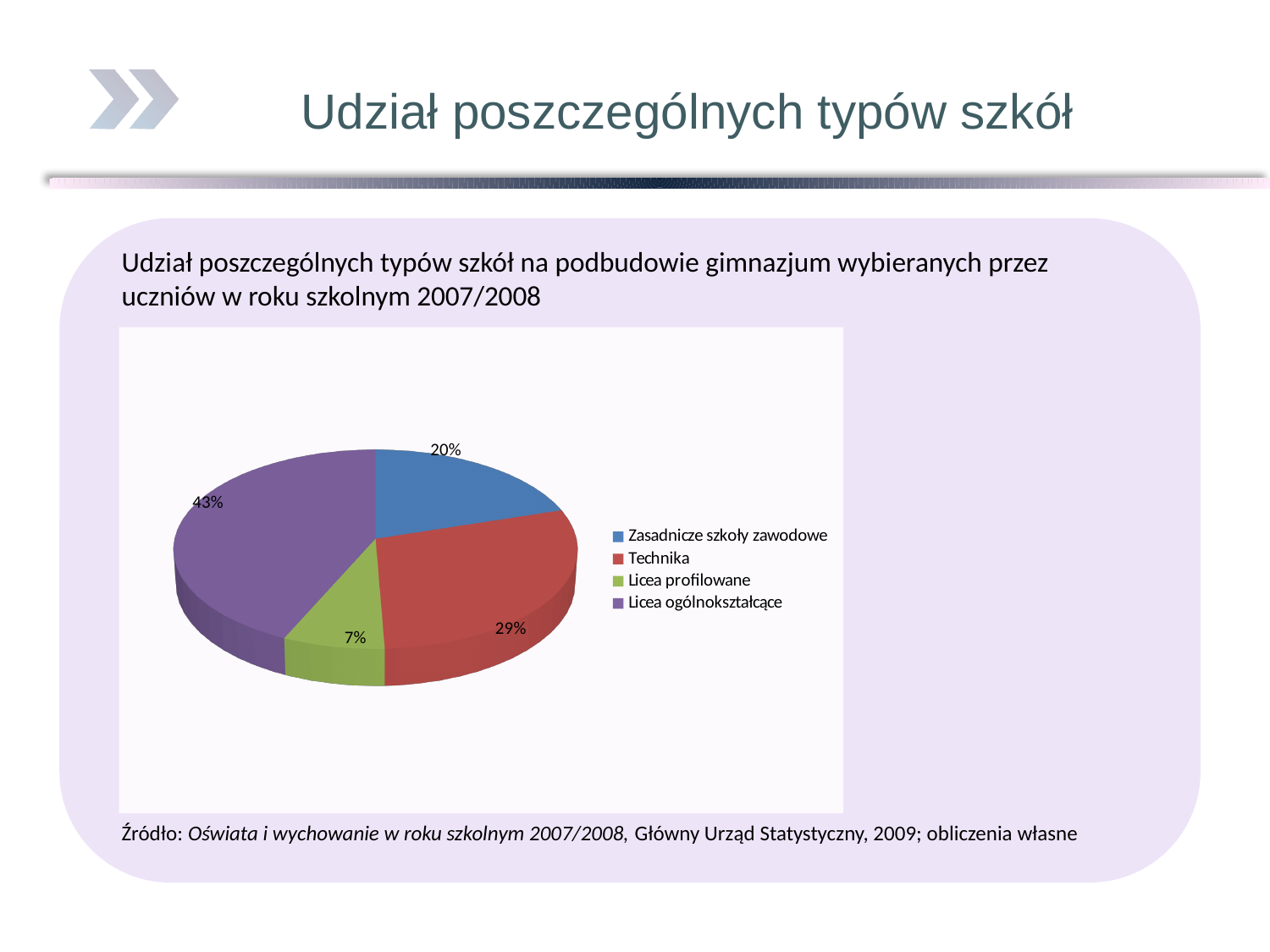
Which school type has the largest slice of the pie? Licea ogólnokształcące What is the difference in percentage points between Zasadnicze szkoły zawodowe and Licea profilowane? 13 What kind of chart is shown on the slide? pie chart Which colour represents Technika in the legend? red How many slices does the pie chart have? 4 What share of the pie does Licea ogólnokształcące have? 43% Which has a larger share, Technika or Zasadnicze szkoły zawodowe? Technika What share of the pie does Licea profilowane have? 7% What is the difference in percentage points between Licea ogólnokształcące and Technika? 14 What share of the pie does Technika have? 29% Which school type has the smallest slice of the pie? Licea profilowane